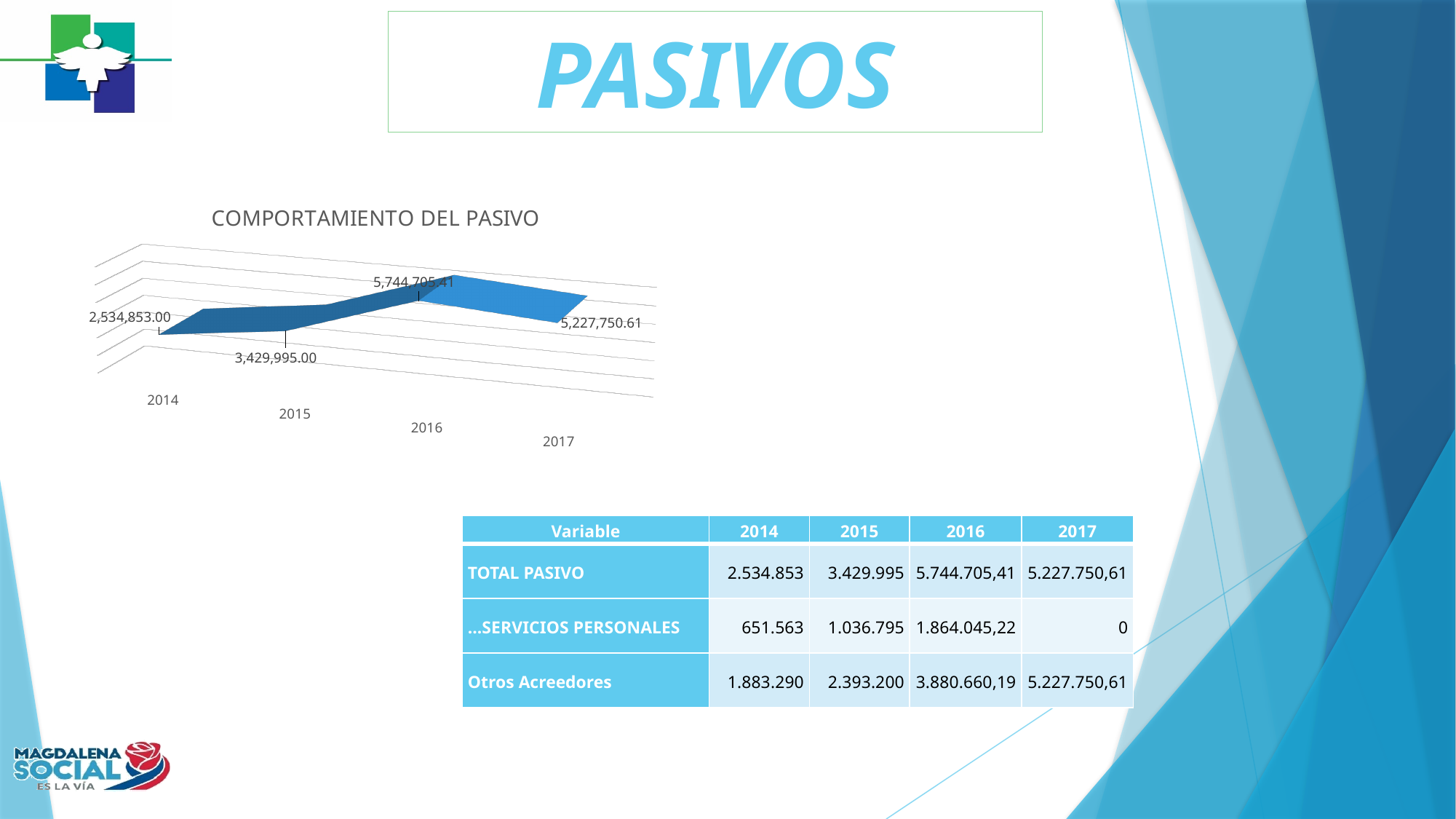
What is the value shown for 2015 in the chart? 3,429,995.00 What is the value shown for 2016 in the chart? 5,744,705.41 Which year has the highest value in the chart? 2016 What is the value shown for 2014 in the chart? 2,534,853.00 Is the value for 2016 or 2017 larger in the chart? 2016 How does the value change from 2014 to 2016 in the chart? It rises Which year has the lowest value in the chart? 2014 What is the difference between the 2016 and 2015 values in the chart? 2,314,710.41 What is the value shown for 2017 in the chart? 5,227,750.61 What type of chart is used to show the COMPORTAMIENTO DEL PASIVO? Line chart (3D) What is the title of the chart on the slide? COMPORTAMIENTO DEL PASIVO How many years are plotted on the x axis of the chart? 4